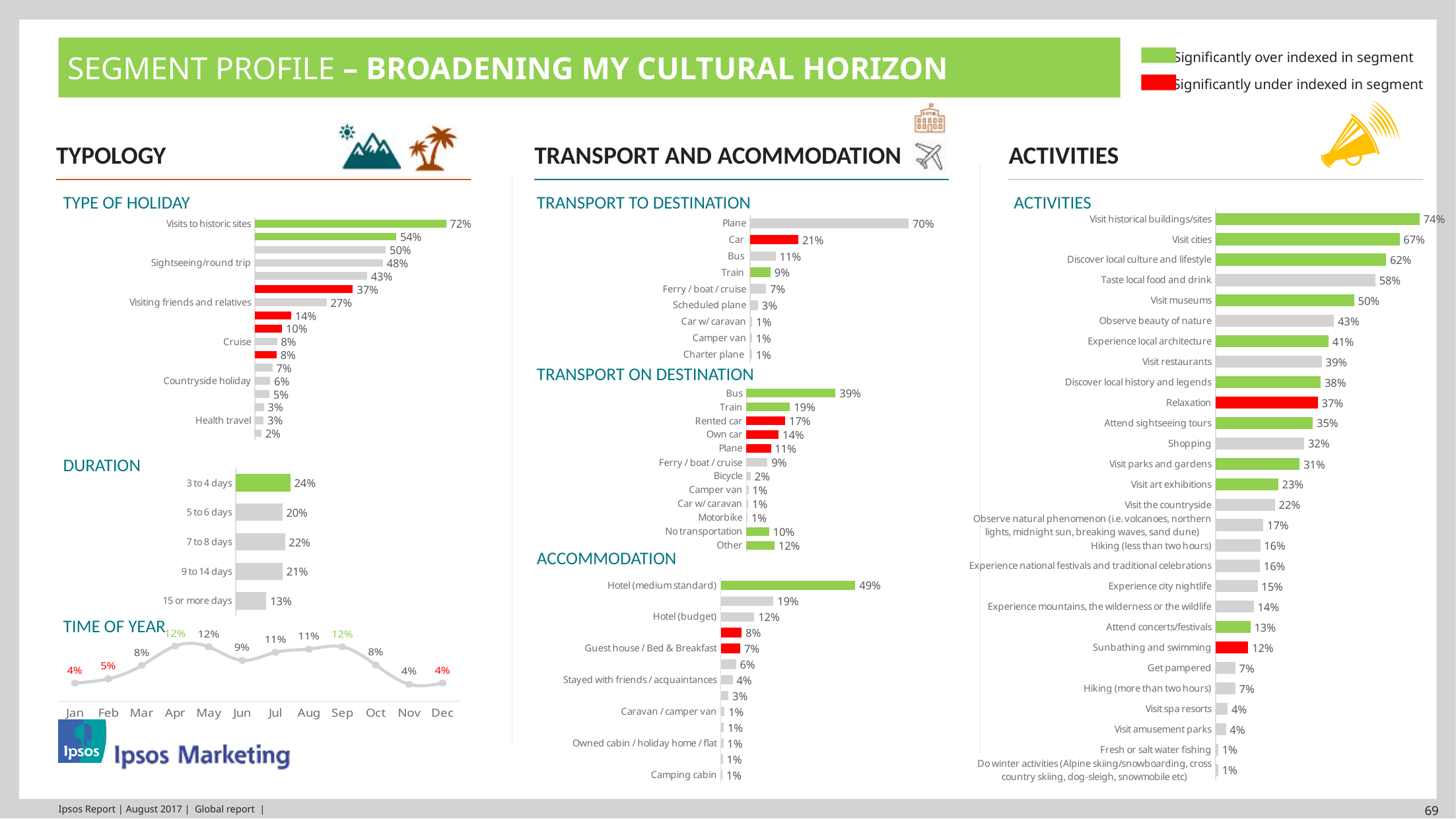
In the Time of Year chart, do the values rise or fall from Sep to Nov? Fall In the Transport to Destination chart, what is the value for Plane? 70% In the Activities chart, what colour is the bar for Relaxation? Red In the Activities chart, what is the difference between Visit historical buildings/sites and Visit cities? 7% In the Duration chart, which category has the lowest value? 15 or more days How many categories does the Duration chart show? 5 What kind of chart is the Time of Year chart? Line chart In the Activities chart, what is the value for Visit museums? 50% In the Accommodation chart, which is larger: Hotel (medium standard) or Hotel (budget)? Hotel (medium standard) In the Transport to Destination chart, what is the difference between Car and Bus? 10% In the Time of Year chart, what is the value for Sep? 12% In the Transport on Destination chart, which category has the highest value? Bus